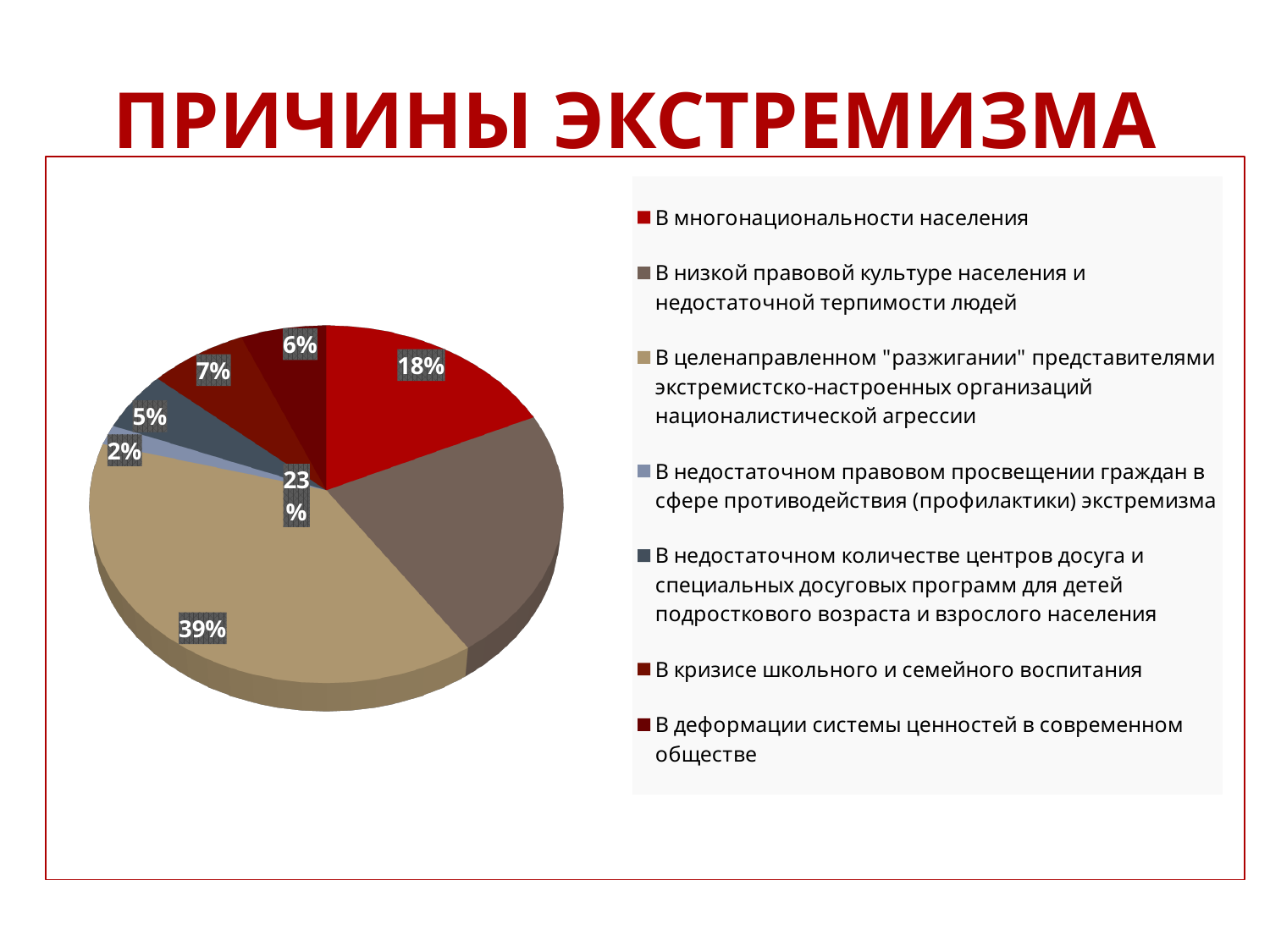
What kind of chart is shown on the slide? pie chart What is the title of the slide containing the chart? ПРИЧИНЫ ЭКСТРЕМИЗМА Which category has the largest slice of the pie? В целенаправленном "разжигании" представителями экстремистско-настроенных организаций националистической агрессии What percentage is shown for "В целенаправленном "разжигании" представителями экстремистско-настроенных организаций националистической агрессии"? 39% How many categories does the legend list? 7 What share of the pie is labelled for "В многонациональности населения"? 18% What percentage is shown for "В недостаточном правовом просвещении граждан в сфере противодействия (профилактики) экстремизма"? 2% What percentage is shown for "В кризисе школьного и семейного воспитания"? 7% What percentage is shown for "В низкой правовой культуре населения и недостаточной терпимости людей"? 23% Which is larger: the share for "В кризисе школьного и семейного воспитания" or for "В деформации системы ценностей в современном обществе"? В кризисе школьного и семейного воспитания Which category has the smallest slice of the pie? В недостаточном правовом просвещении граждан в сфере противодействия (профилактики) экстремизма What is the difference in percentage points between the 39% slice and the 23% slice? 16